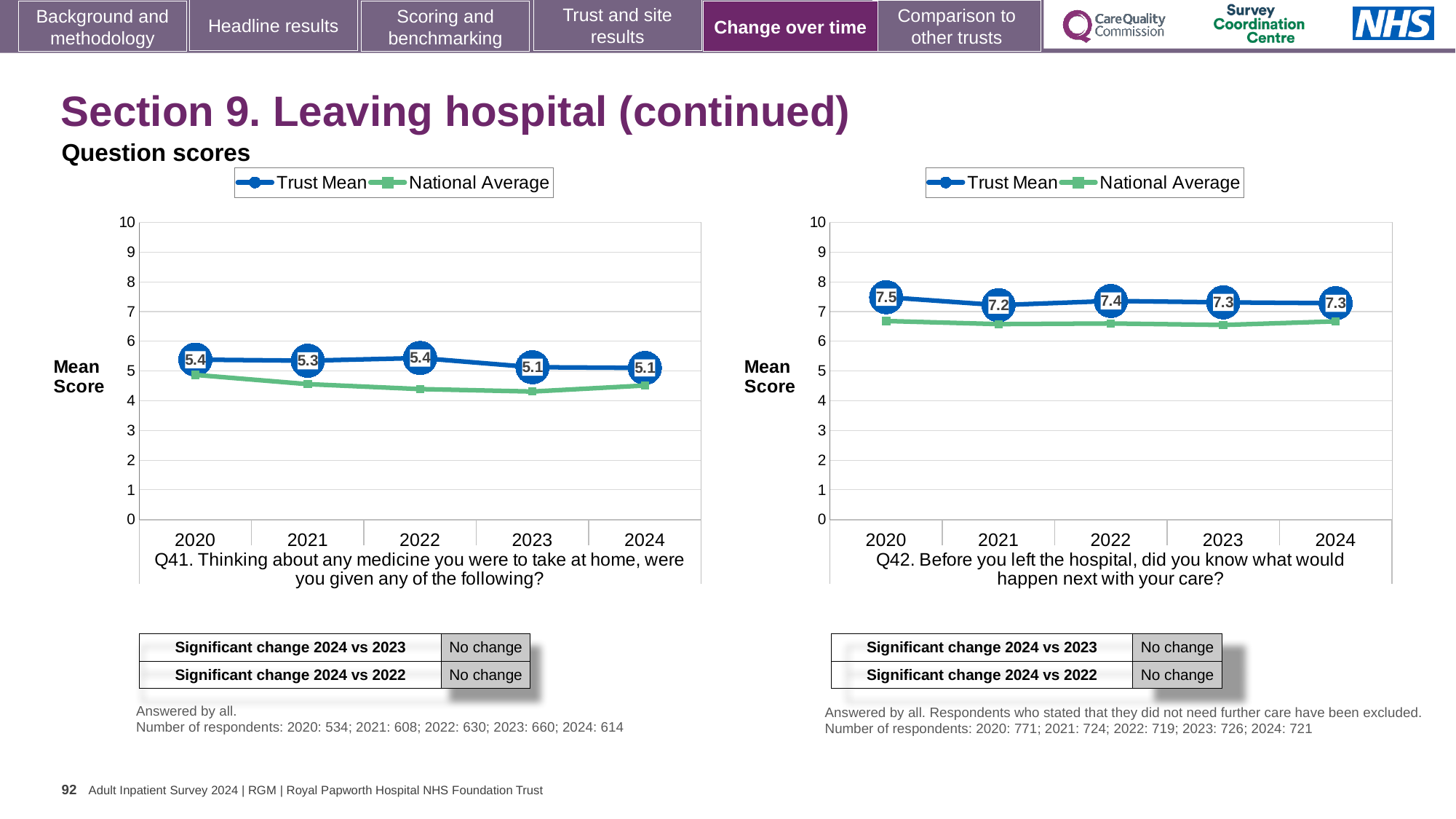
How many series does the legend of the Q41 chart list? 2 In the Q42 chart, what is the Trust Mean score for 2021? 7.2 In the Q42 chart, which year has the highest Trust Mean score? 2020 In the Q42 chart, what is the difference between the Trust Mean score in 2020 and in 2021? 0.3 In the Q42 chart, what is the Trust Mean score for 2024? 7.3 In the Q41 chart, is the National Average for 2023 greater or less than 5? less In the Q41 chart, what is the Trust Mean score for 2024? 5.1 In the Q42 chart, is the National Average for 2020 greater or less than 6? greater In the Q41 chart, what is the Trust Mean score for 2020? 5.4 What kind of chart is the Q42 chart? Line chart In the Q42 chart, which year has the lowest Trust Mean score? 2021 In the Q41 chart, what is the difference between the Trust Mean score in 2022 and in 2023? 0.3